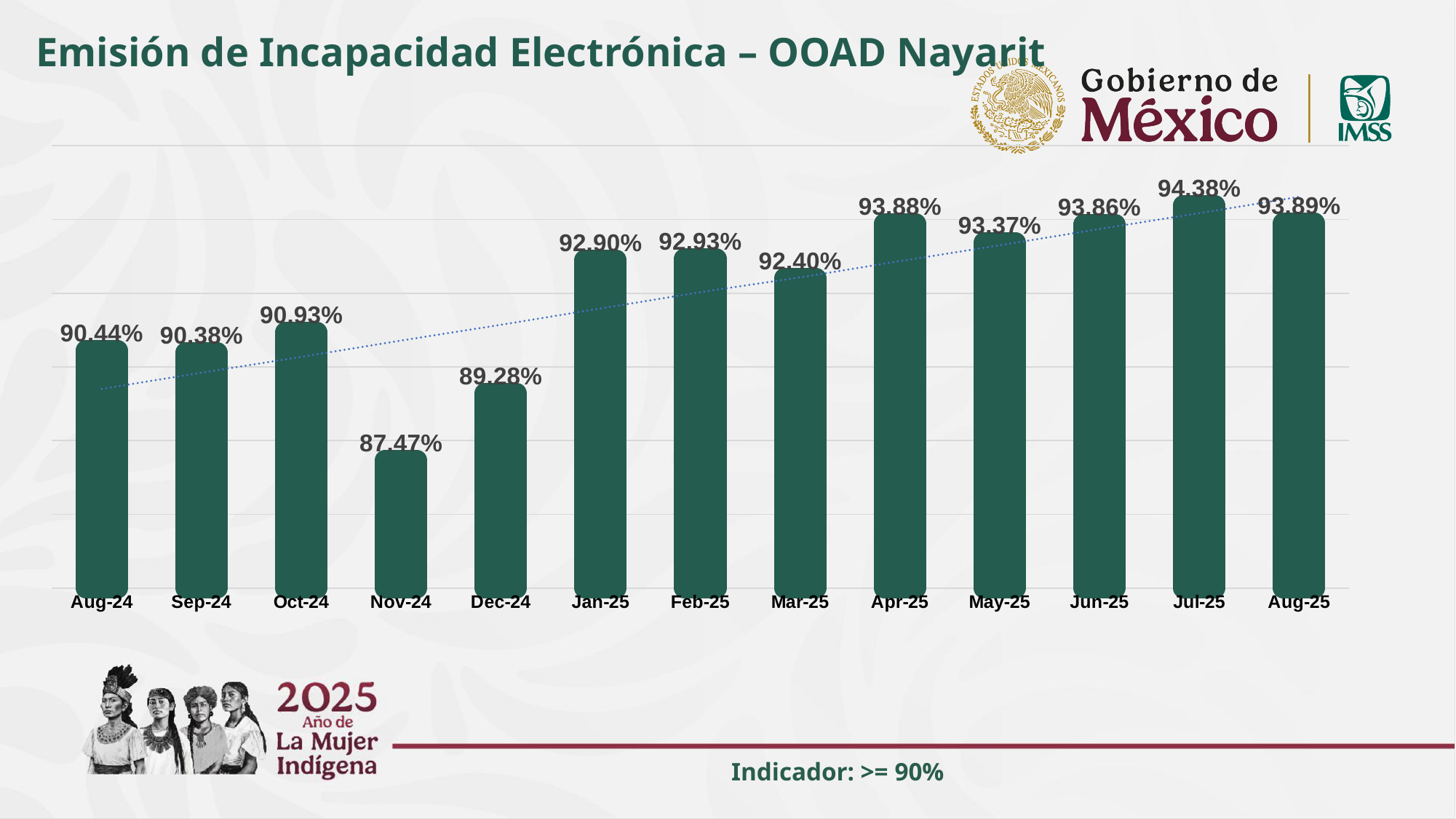
Which month has the lowest value? Nov-24 Which month has the highest value? Jul-25 Do the values generally rise or fall from Aug-24 to Aug-25? Rise What is the value for Nov-24? 87.47% Which is larger, the value for Oct-24 or the value for Mar-25? Mar-25 What is the difference between the values for Jul-25 and Nov-24? 6.91 percentage points What is the title of the chart? Emisión de Incapacidad Electrónica – OOAD Nayarit How many months (bars) are plotted in the chart? 13 What is the value for Mar-25? 92.40% What is the difference between the values for Dec-24 and Nov-24? 1.81 percentage points What type of chart is shown on the slide? Bar chart What is the value for Jul-25? 94.38%